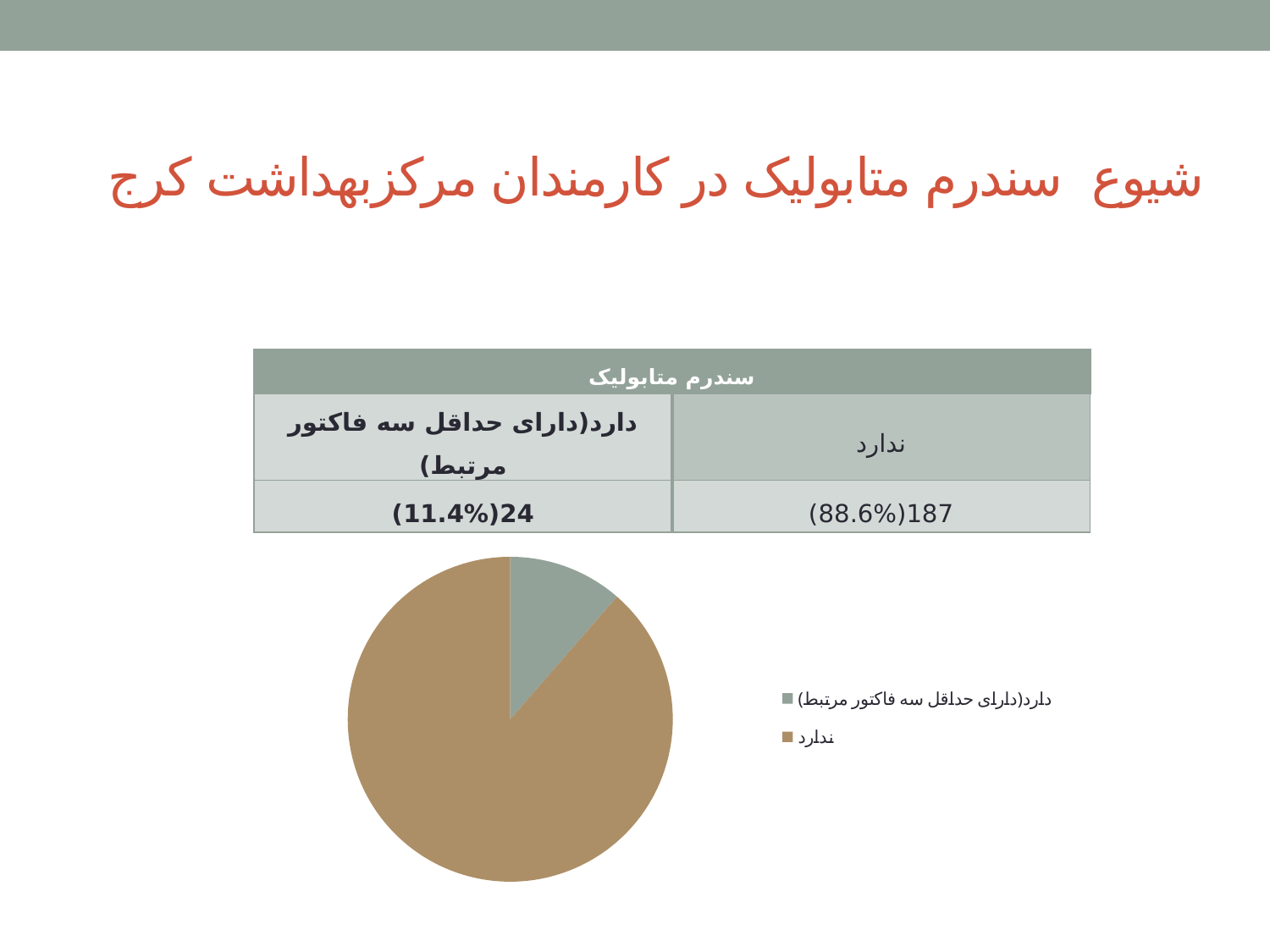
How many slices does the pie chart have? 2 What is the title of the table above the pie chart? سندرم متابولیک Which category has the smallest slice in the pie chart? دارد(دارای حداقل سه فاکتور مرتبط) According to the table above the pie chart, how many people are in the دارد(دارای حداقل سه فاکتور مرتبط) category? 24 What colour is the ندارد slice in the pie chart? brown What kind of chart is shown on the slide? pie chart According to the table above the pie chart, how many people are in the ندارد category? 187 Which category has the largest slice in the pie chart? ندارد According to the table above the pie chart, what is the share of the ندارد slice? 88.6% How many entries does the legend of the pie chart list? 2 Which slice is larger in the pie chart, ندارد or دارد(دارای حداقل سه فاکتور مرتبط)? ندارد According to the table above the pie chart, what is the share of the دارد(دارای حداقل سه فاکتور مرتبط) slice? 11.4%